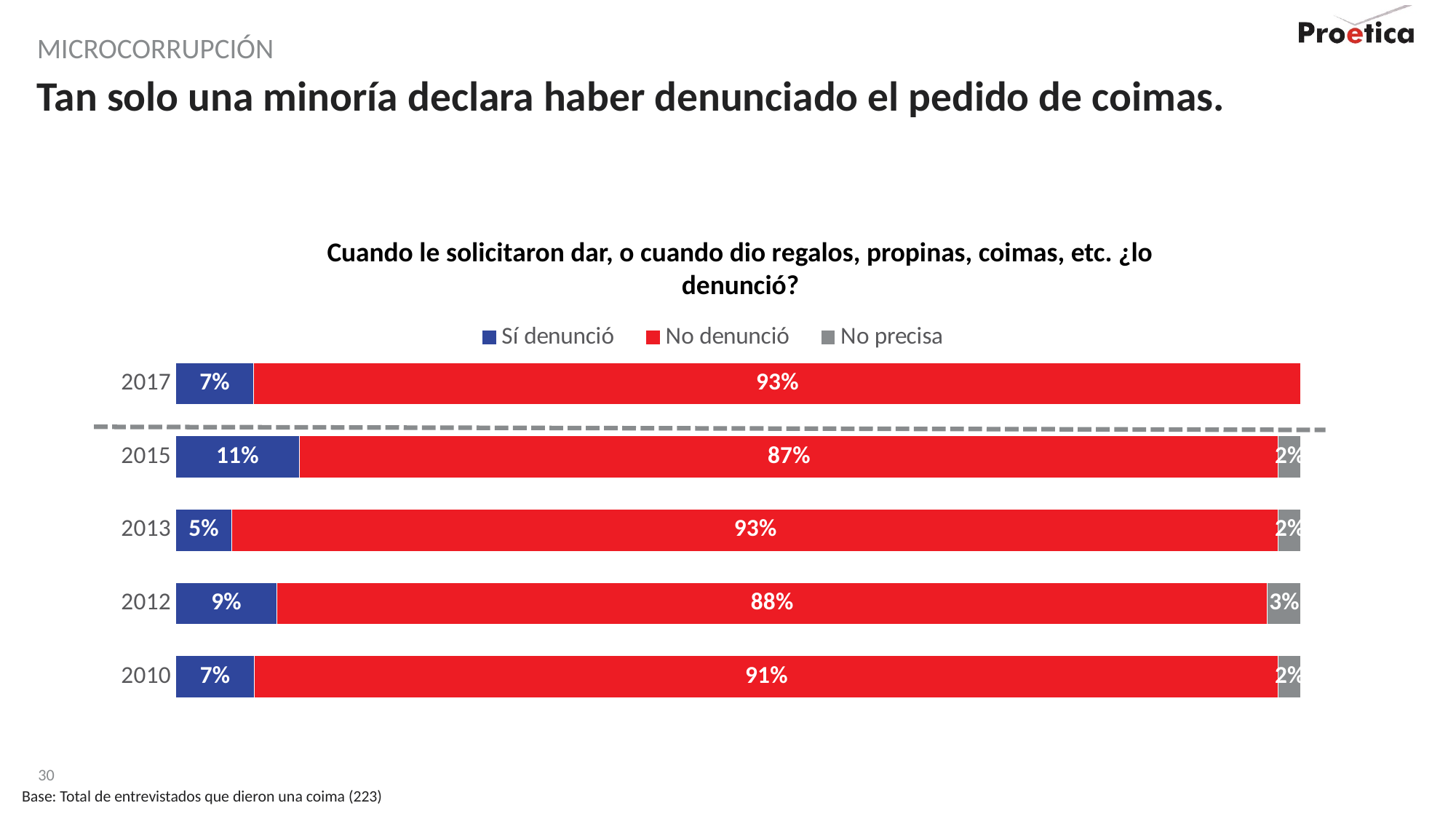
What is the value for "Sí denunció" in 2015? 11% What kind of chart is shown on the slide? Stacked bar chart In which year is the "Sí denunció" value lowest? 2013 What is the value for "No precisa" in 2012? 3% How many series does the legend list? 3 What is the difference between the "No denunció" values for 2017 and 2015? 6 percentage points Which series is shown in red in the chart? No denunció Which is larger: the "Sí denunció" value in 2012 or in 2013? 2012 What is the value for "Sí denunció" in 2017? 7% How many years (categories) are shown in the chart? 5 In which year is the "Sí denunció" value highest? 2015 What is the value for "No denunció" in 2010? 91%